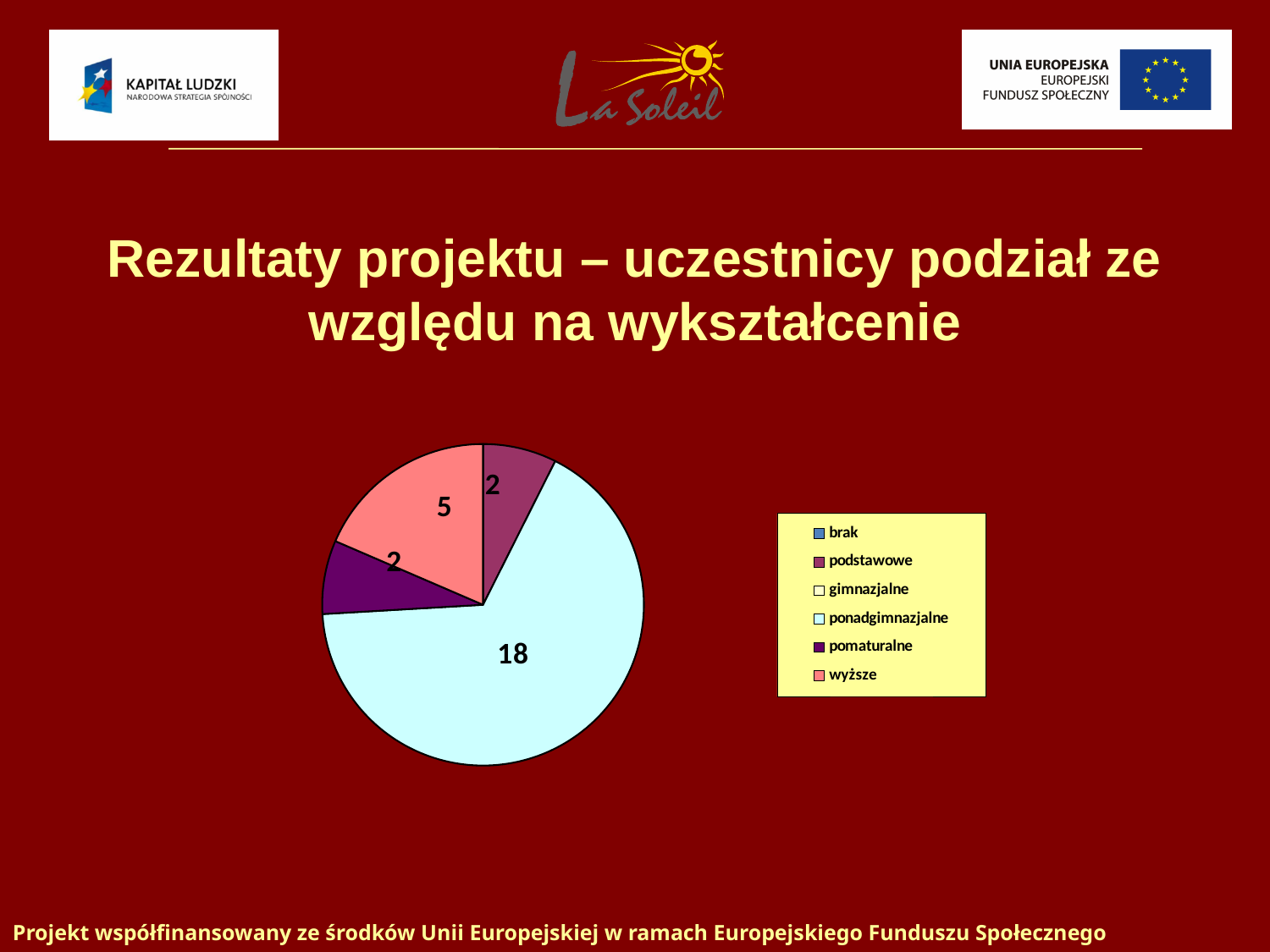
What is the difference between the values for wyższe and pomaturalne? 3 What is the title of the slide containing the pie chart? Rezultaty projektu – uczestnicy podział ze względu na wykształcenie What is the value for podstawowe in the pie chart? 2 What kind of chart is shown on the slide? pie chart How many entries does the legend of the pie chart list? 6 Which is larger, the value for wyższe or the value for pomaturalne? wyższe Which legend entry is listed first in the pie chart's legend? brak What is the difference between the values for ponadgimnazjalne and wyższe? 13 What is the value for pomaturalne in the pie chart? 2 Which category has the largest slice in the pie chart? ponadgimnazjalne What is the value for ponadgimnazjalne in the pie chart? 18 What is the value for wyższe in the pie chart? 5